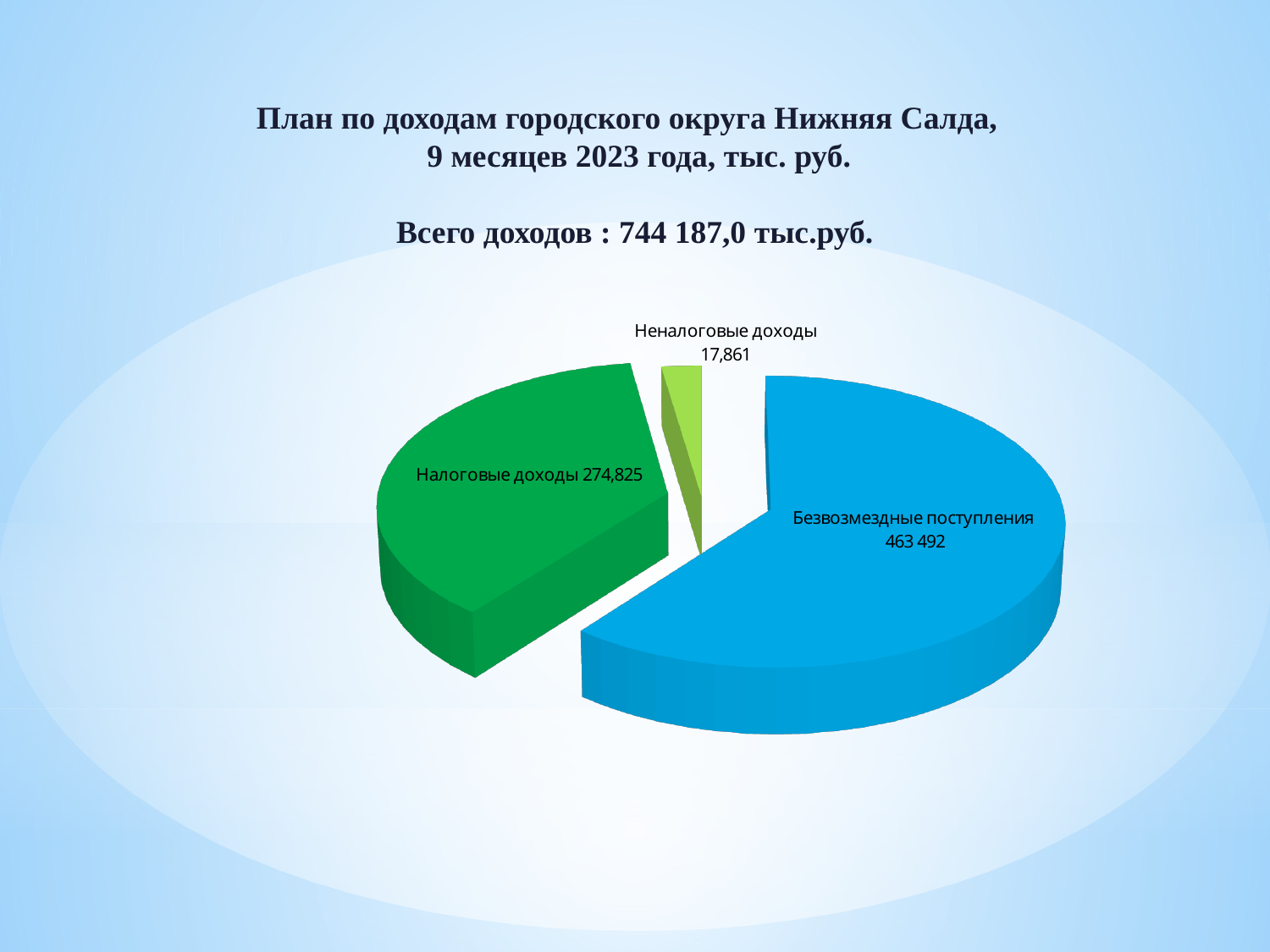
Which category has the largest slice of the pie? Безвозмездные поступления What total income (Всего доходов) is stated on the slide? 744 187,0 тыс.руб. What kind of chart is shown on the slide? Pie chart Which category has the smallest slice of the pie? Неналоговые доходы How many categories are shown in the pie chart? 3 What value is shown for Неналоговые доходы? 17,861 What colour is the slice for Безвозмездные поступления? Blue What value is shown for Безвозмездные поступления? 463 492 Which is larger, Безвозмездные поступления or Налоговые доходы? Безвозмездные поступления What value is shown for Налоговые доходы? 274,825 Which is larger, Налоговые доходы or Неналоговые доходы? Налоговые доходы